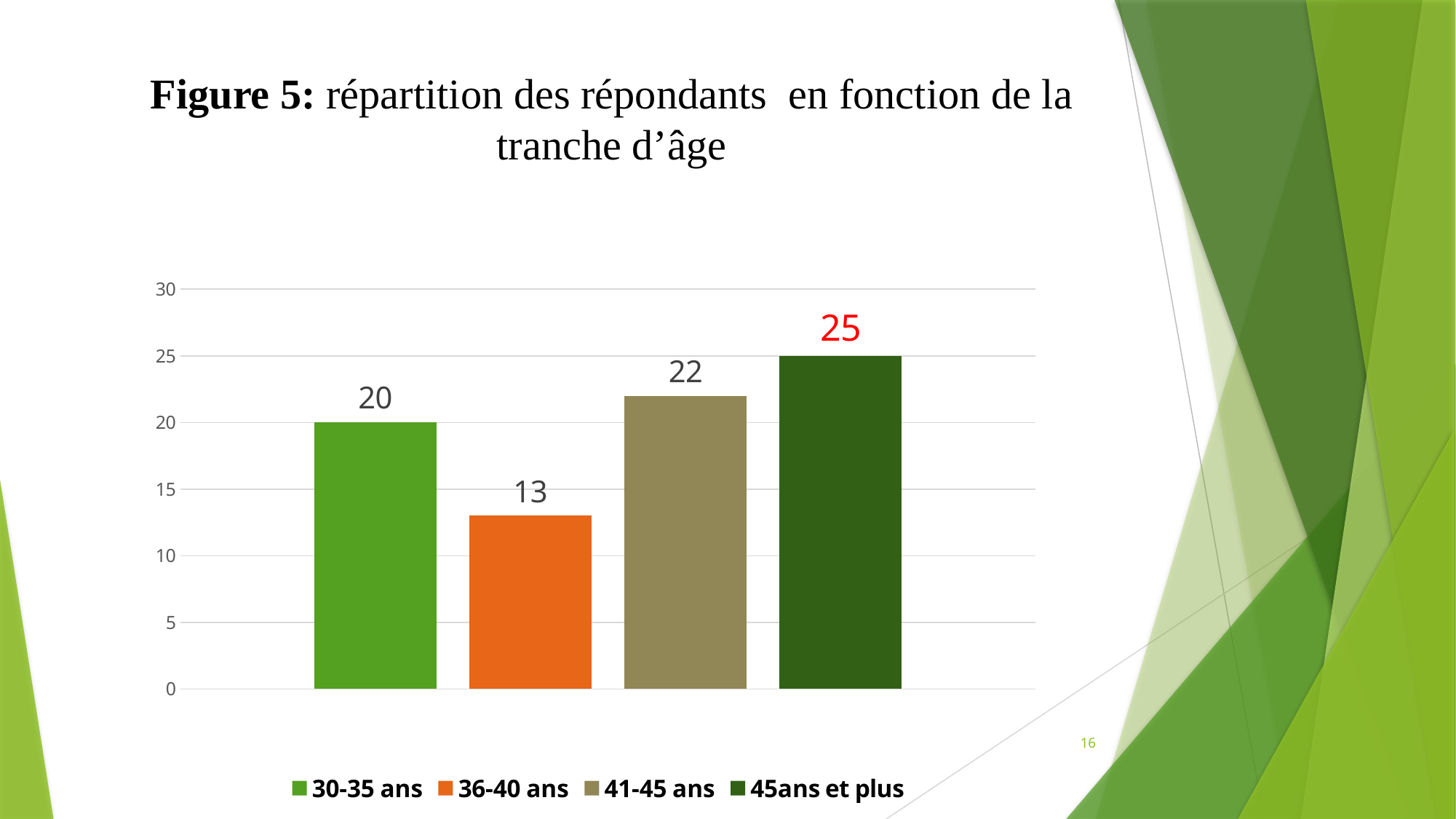
What is the value for the 45ans et plus category? 25 What is the difference between the values for 45ans et plus and 36-40 ans? 12 Which is larger, the value for 30-35 ans or the value for 41-45 ans? 41-45 ans What kind of chart is shown on the slide? Bar chart How many age groups are shown in the chart? 4 Which age group has the lowest value? 36-40 ans What is the value for the 30-35 ans category? 20 How many entries does the legend list? 4 What is the value for the 36-40 ans category? 13 Which age group has the highest value? 45ans et plus What colour is the bar for 36-40 ans? Orange What is the value for the 41-45 ans category? 22